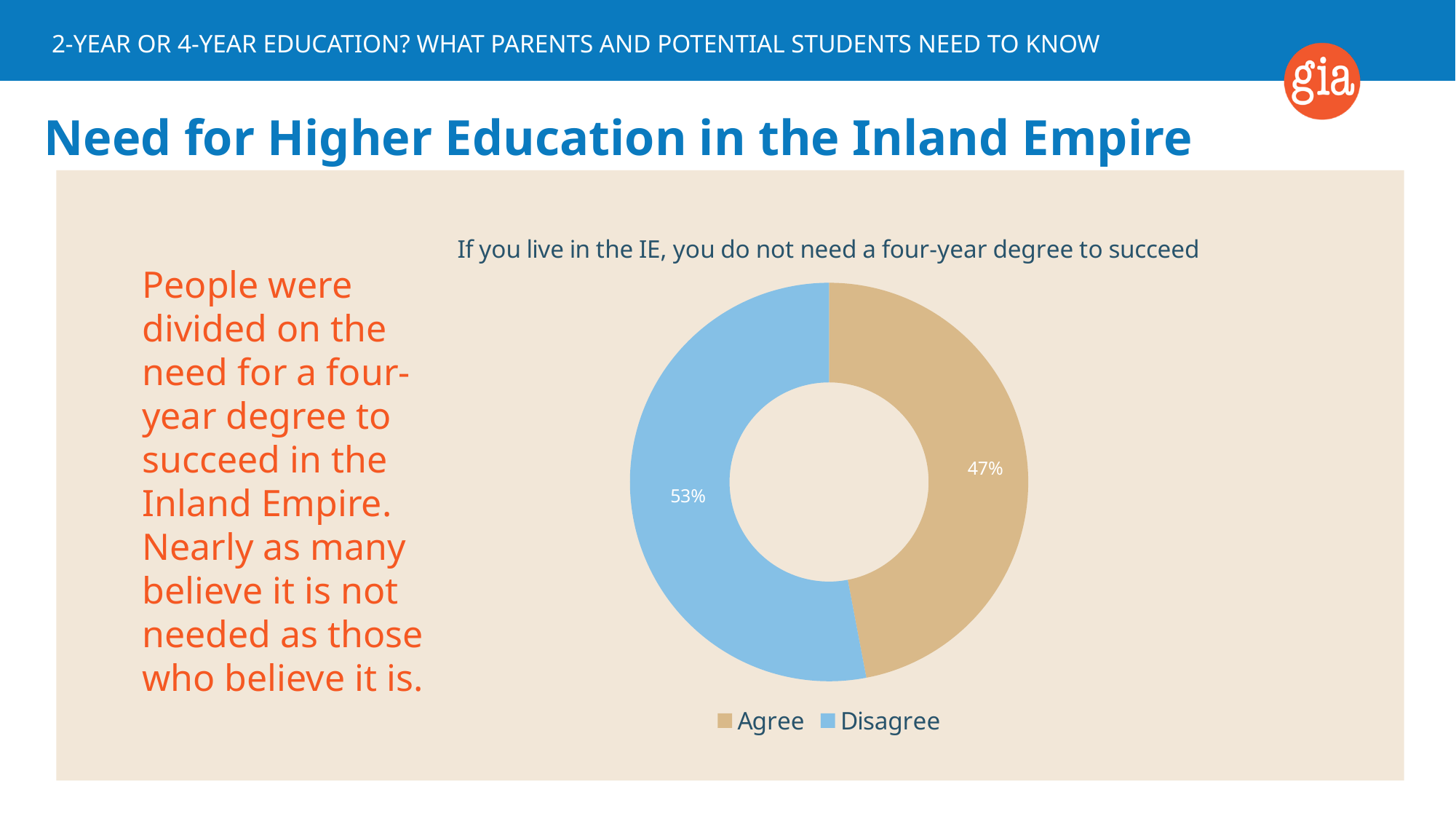
Which colour represents the Disagree category in the chart? Blue Which response has the larger share of the chart, Agree or Disagree? Disagree What is the difference in percentage points between the Disagree and Agree shares? 6 percentage points What do the Agree and Disagree shares add up to? 100% How many categories does the chart show? 2 What is the title of the chart? If you live in the IE, you do not need a four-year degree to succeed What percentage of respondents disagree with the statement that you do not need a four-year degree to succeed in the IE? 53% Which response has the smaller share of the chart? Agree Is the Disagree share greater or less than 50%? greater Is the Agree share larger or smaller than the Disagree share? Smaller What percentage of respondents agree that if you live in the IE, you do not need a four-year degree to succeed? 47% What kind of chart is shown on the slide? Doughnut (pie) chart